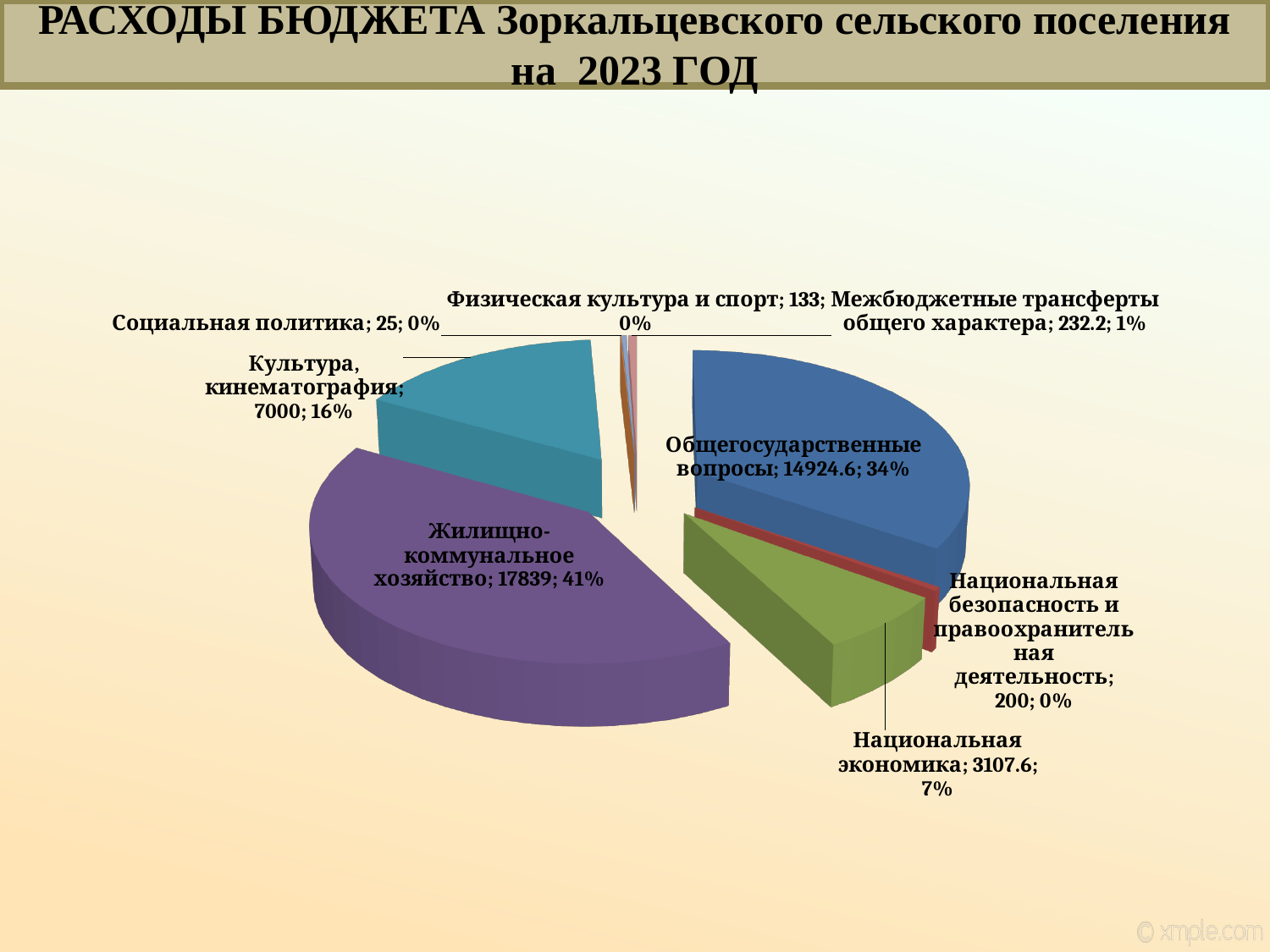
What kind of chart is shown on the slide? pie chart What share of the pie does Национальная экономика take? 7% What is the value for Жилищно-коммунальное хозяйство? 17839 What share of the pie does Культура, кинематография take? 16% What is the value for Национальная экономика? 3107.6 Which category has the largest slice of the pie? Жилищно-коммунальное хозяйство Which category has the smallest value? Социальная политика Which is larger: the value for Культура, кинематография or the value for Национальная экономика? Культура, кинематография What is the value for Общегосударственные вопросы? 14924.6 What is the value for Межбюджетные трансферты общего характера? 232.2 How many categories (slices) does the pie chart show? 8 What is the difference between the values for Жилищно-коммунальное хозяйство and Общегосударственные вопросы? 2914.4